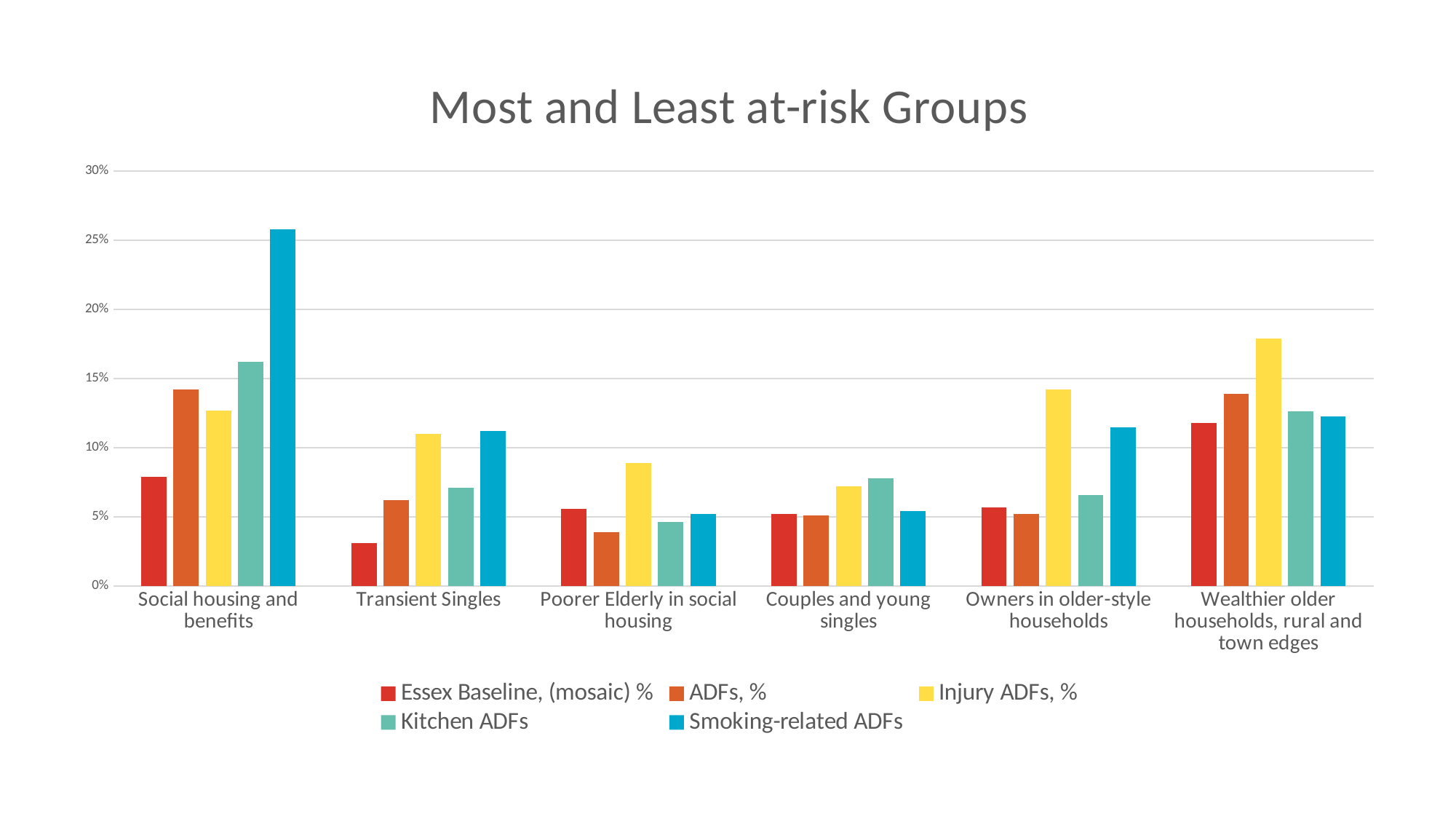
How many series does the legend list? 5 Is the Injury ADFs, % value for Wealthier older households, rural and town edges greater or less than 15%? greater How many groups (categories) are shown along the x axis? 6 Which group has the highest value for Smoking-related ADFs? Social housing and benefits What is the title of the chart? Most and Least at-risk Groups Is the Essex Baseline, (mosaic) % value for Transient Singles greater or less than 5%? less Is the Smoking-related ADFs value for Social housing and benefits greater or less than 20%? greater For Owners in older-style households, which is larger: Injury ADFs, % or Kitchen ADFs? Injury ADFs, % Which group has the highest value for Injury ADFs, %? Wealthier older households, rural and town edges Which group has the lowest value for Essex Baseline, (mosaic) %? Transient Singles What kind of chart is shown on the slide? Bar chart Which has the larger Smoking-related ADFs value: Transient Singles or Poorer Elderly in social housing? Transient Singles